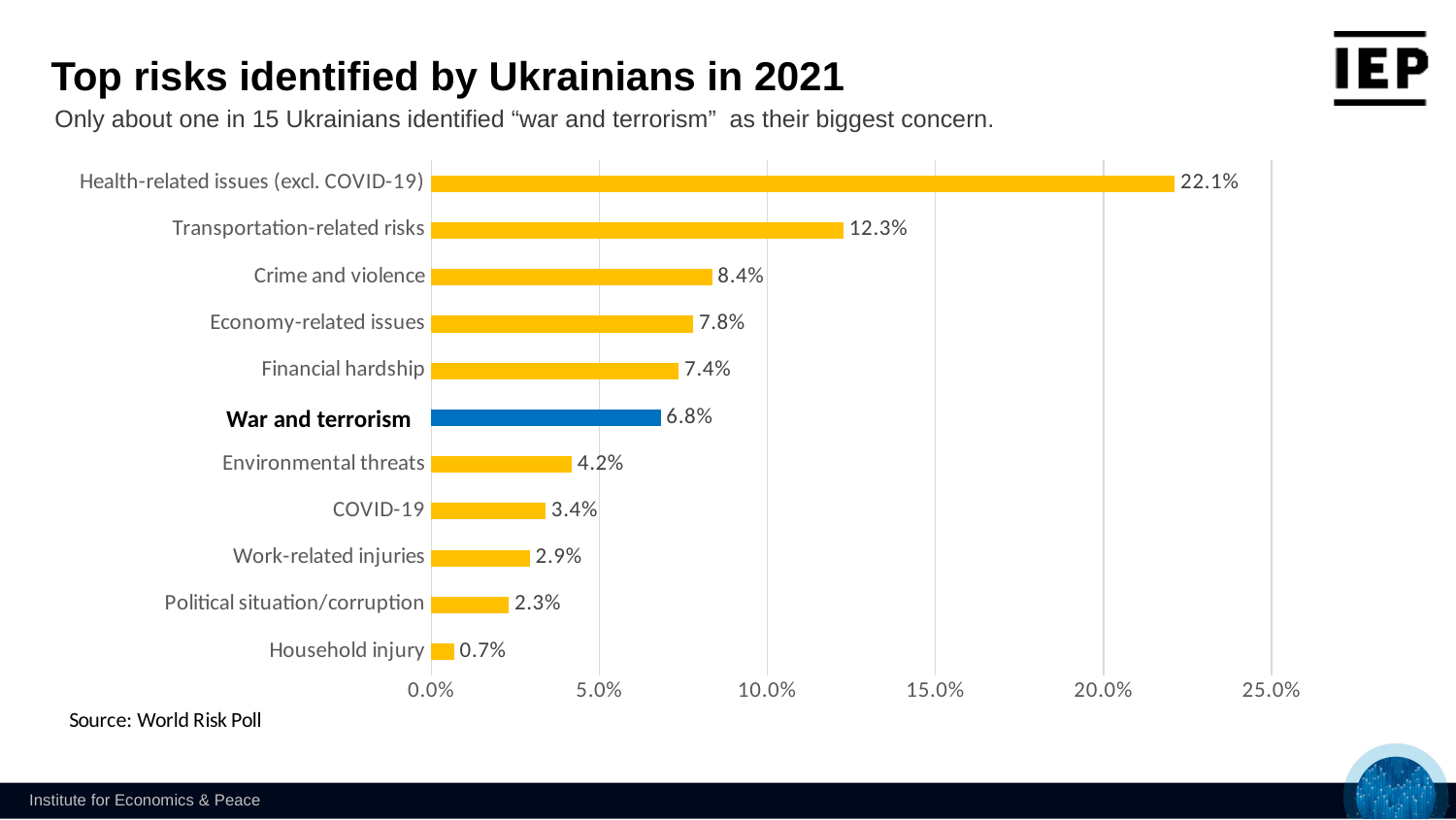
Which risk category has the lowest value? Household injury What is the value shown for War and terrorism? 6.8% What is the value shown for COVID-19? 3.4% Which bar is highlighted in a different colour (blue) from the others? War and terrorism What kind of chart is shown on the slide? Bar chart Which is larger, the value for Environmental threats or the value for Work-related injuries? Environmental threats What percentage of Ukrainians identified health-related issues (excl. COVID-19) as their biggest concern? 22.1% What is the difference between the values for Transportation-related risks and Crime and violence? 3.9% Is the value for Economy-related issues greater or less than 10.0%? less Which risk category has the highest value? Health-related issues (excl. COVID-19) How many risk categories are shown in the chart? 11 What is the difference between the values for Financial hardship and War and terrorism? 0.6%